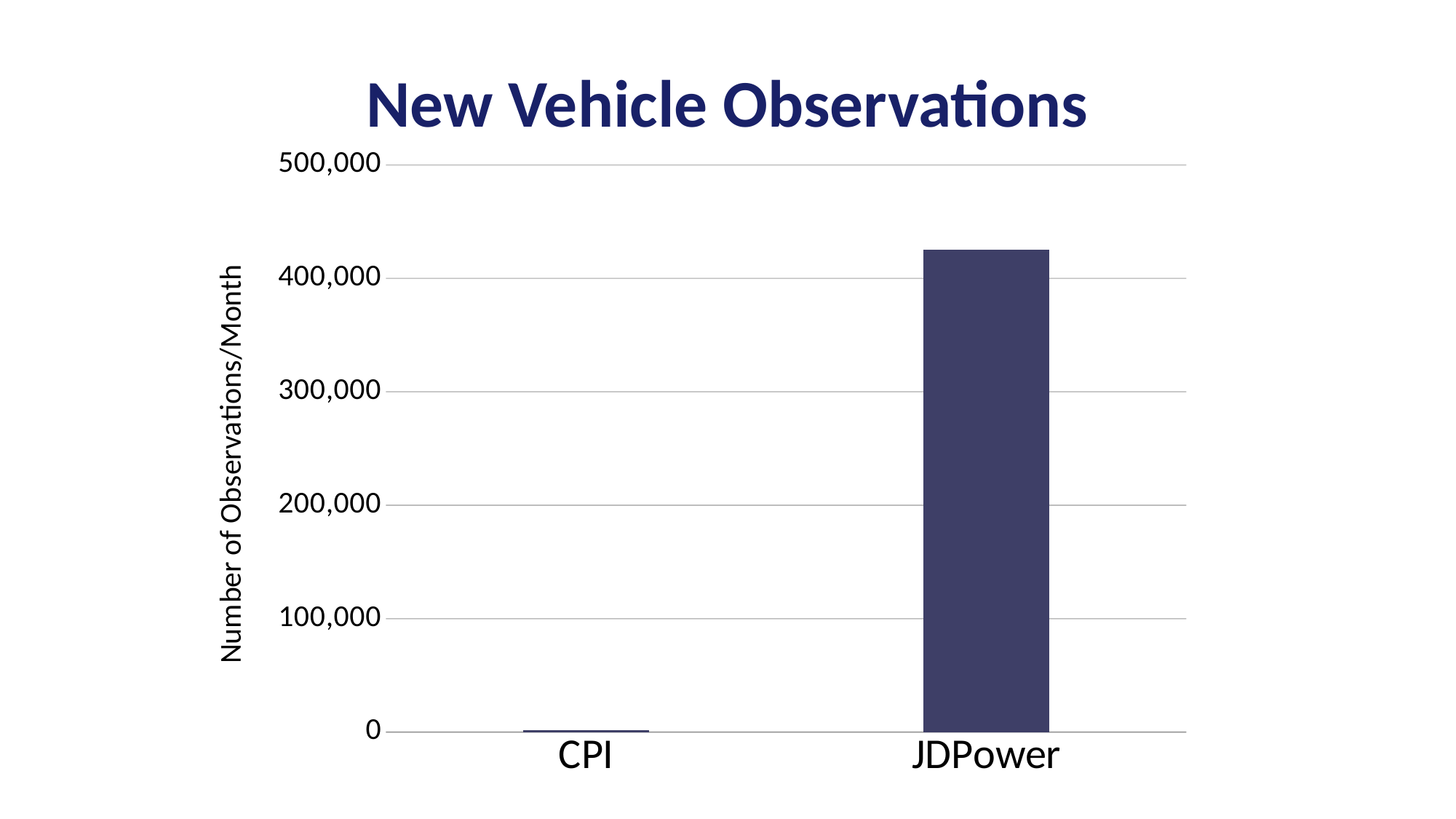
Which category has the highest number of observations per month? JDPower What is the title of the chart? New Vehicle Observations Which has more observations per month, CPI or JDPower? JDPower How many categories are shown on the x axis? 2 What is the highest value shown on the vertical axis? 500,000 Is the value for JDPower greater or less than 400,000? greater Which category has the lowest number of observations per month? CPI What is the label of the vertical axis? Number of Observations/Month Is the value for CPI greater or less than 100,000? less Is the value for JDPower greater or less than 500,000? less What kind of chart is shown on the slide? bar chart